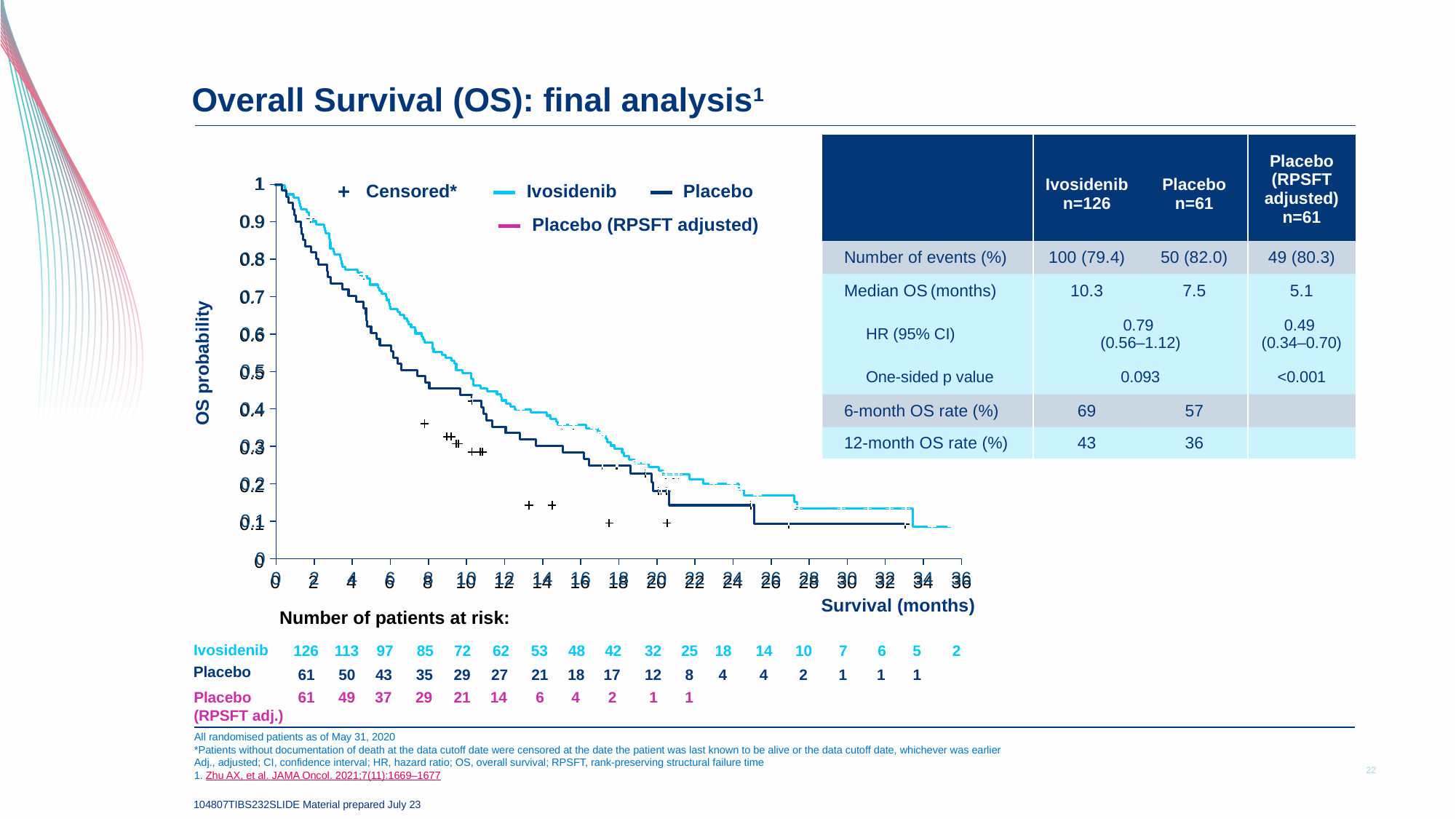
How many Placebo patients were at risk at 10 months? 27 What is the label of the y axis of the chart? OS probability How many Placebo (RPSFT adj.) patients were at risk at 12 months? 6 What is the difference between the number of Ivosidenib and Placebo patients at risk at 0 months? 65 Is the OS probability for the Ivosidenib curve at 6 months greater or less than 0.6? greater Which treatment groups are listed in the chart legend? Ivosidenib, Placebo, Placebo (RPSFT adjusted) Which group had more patients at risk at 20 months, Ivosidenib or Placebo? Ivosidenib Do the OS probability curves rise or fall as survival time increases? fall What kind of chart is shown on the slide? line chart (Kaplan-Meier survival curve) Is the OS probability for the Placebo curve at 30 months greater or less than 0.2? less How many Ivosidenib patients were at risk at 0 months? 126